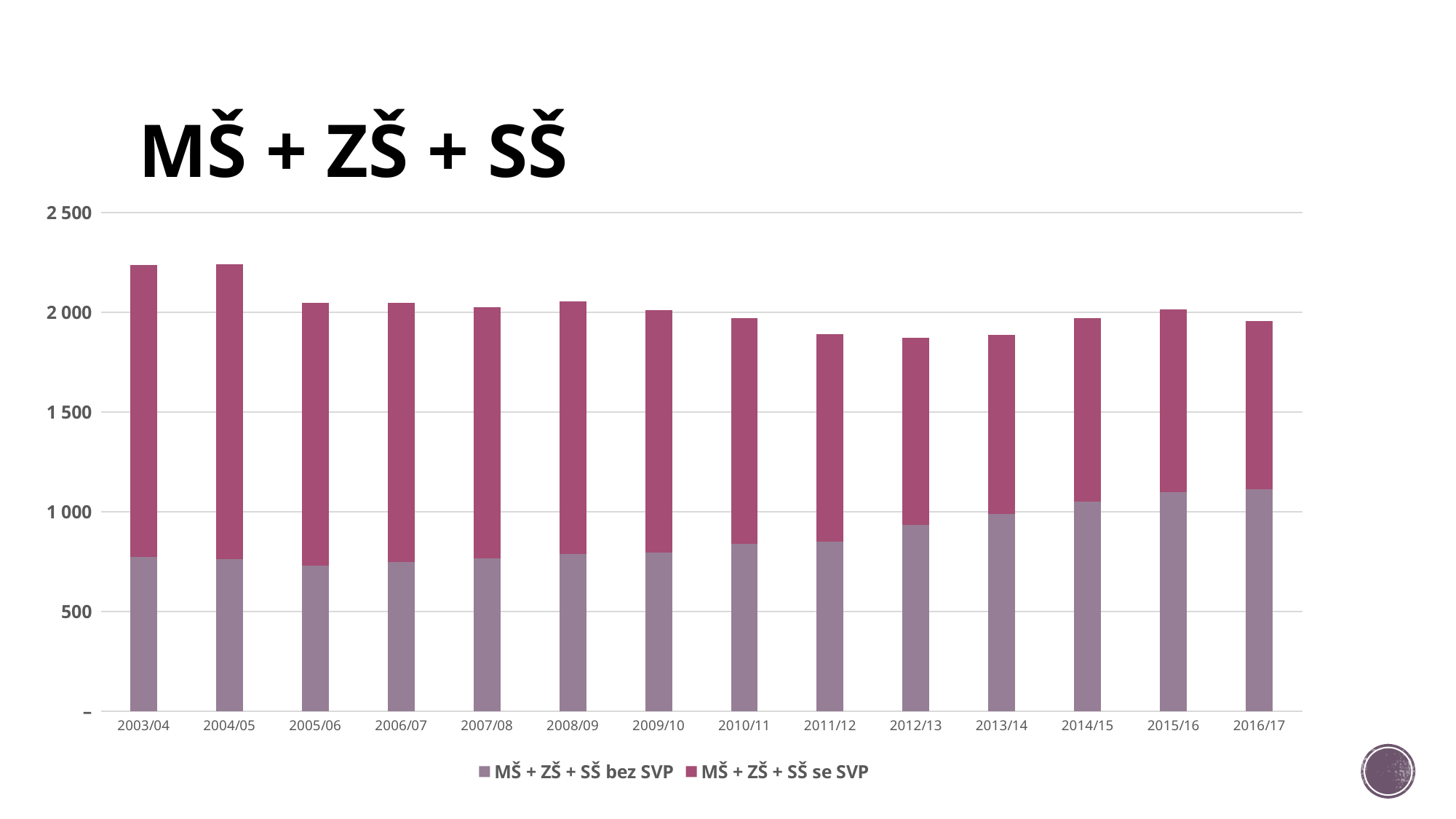
What is the title of the chart? MŠ + ZŠ + SŠ Is the value of MŠ + ZŠ + SŠ bez SVP for 2016/17 greater or less than 1 000? greater What kind of chart is shown on the slide? Stacked bar chart Is the total stacked value for 2011/12 greater or less than 2 000? less Which is larger, the MŠ + ZŠ + SŠ bez SVP value for 2003/04 or for 2016/17? 2016/17 Is the value of MŠ + ZŠ + SŠ bez SVP for 2003/04 greater or less than 1 000? less How many school years are shown on the x axis? 14 How many series does the legend list? 2 Which is larger, the total stacked value for 2003/04 or for 2012/13? 2003/04 Which series is shown in the darker magenta colour? MŠ + ZŠ + SŠ se SVP Does the MŠ + ZŠ + SŠ bez SVP series generally rise or fall from 2005/06 to 2016/17? rise